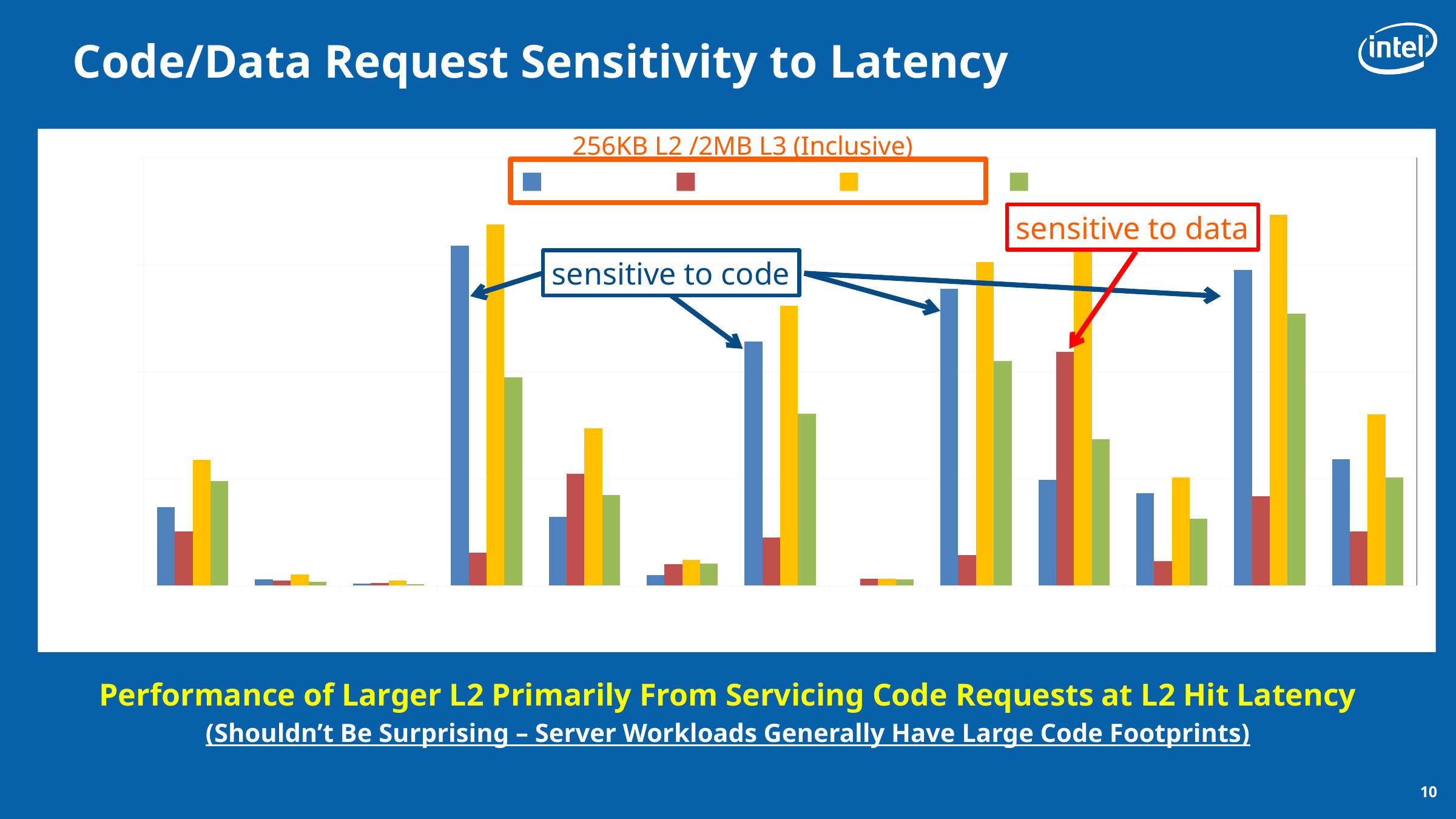
In the fourth group of bars from the left, which colour bar is the tallest? yellow In the last group of bars on the right, which colour bar is the shortest? red How many groups of bars are plotted along the x axis? 13 What is the title shown above the chart? 256KB L2 /2MB L3 (Inclusive) What kind of chart is shown on the slide? bar chart In the eleventh group of bars from the left, which is taller, the red bar or the blue bar? blue What are the two annotation labels placed over the chart? sensitive to code; sensitive to data How many series does the chart's legend list? 4 In the fourth group of bars from the left, which colour bar is the shortest? red In the first group of bars from the left, which is taller, the blue bar or the red bar? blue In the twelfth group of bars from the left, which colour bar is the tallest? yellow In the fifth group of bars from the left, which is taller, the blue bar or the red bar? red